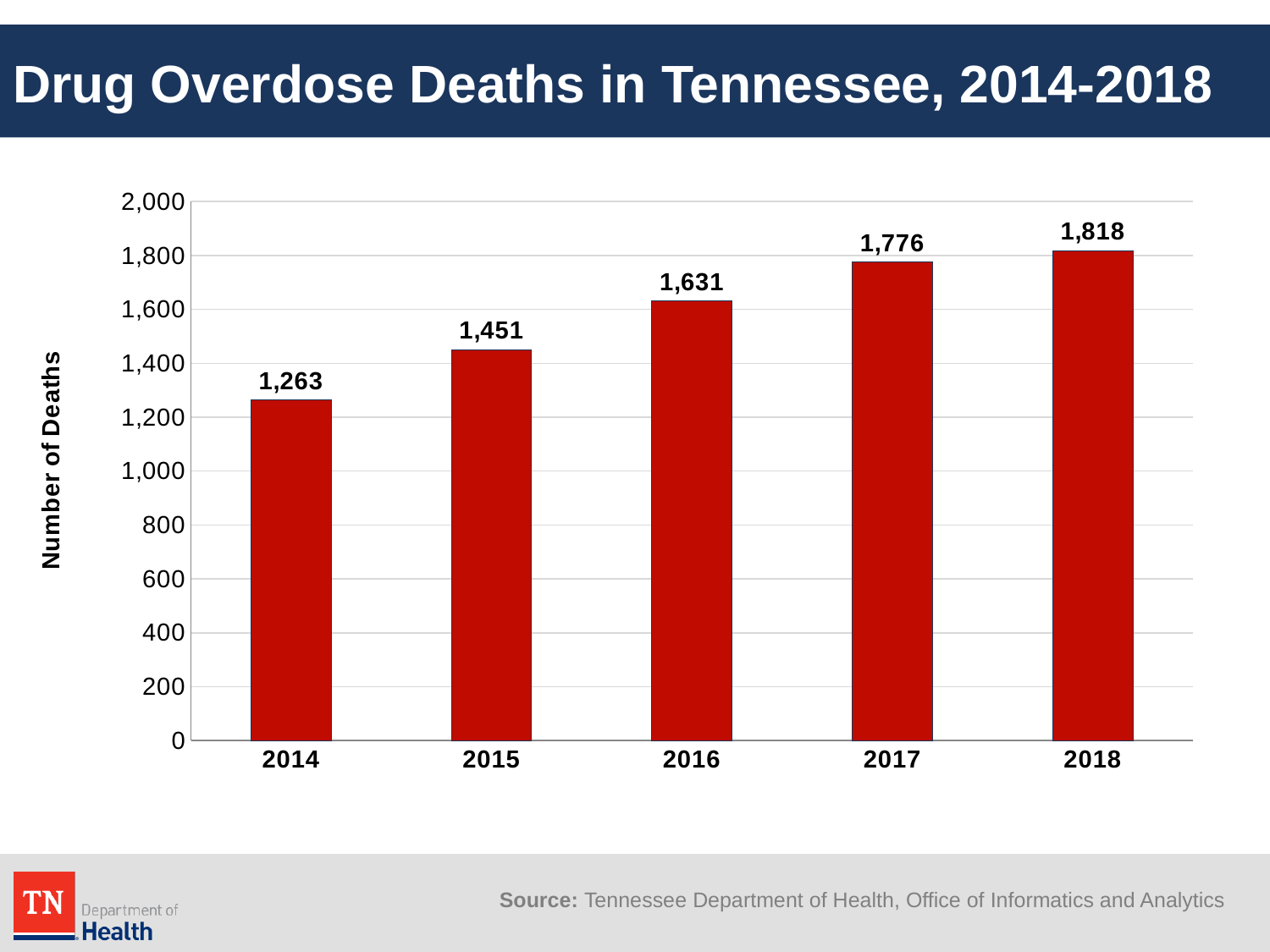
Is the value for 2015 greater or less than 1,400? greater What kind of chart is shown on the slide? Bar chart What is the number of deaths shown for 2016? 1,631 Which year had more deaths, 2015 or 2017? 2017 What is the difference in deaths between 2017 and 2016? 145 Which year has the highest number of drug overdose deaths? 2018 By how much did the number of deaths increase from 2014 to 2018? 555 What is the number of deaths shown for 2018? 1,818 Do the number of deaths rise or fall from 2014 to 2018? Rise How many years are shown on the x axis? 5 Which year has the lowest number of drug overdose deaths? 2014 How many drug overdose deaths were there in Tennessee in 2014? 1,263